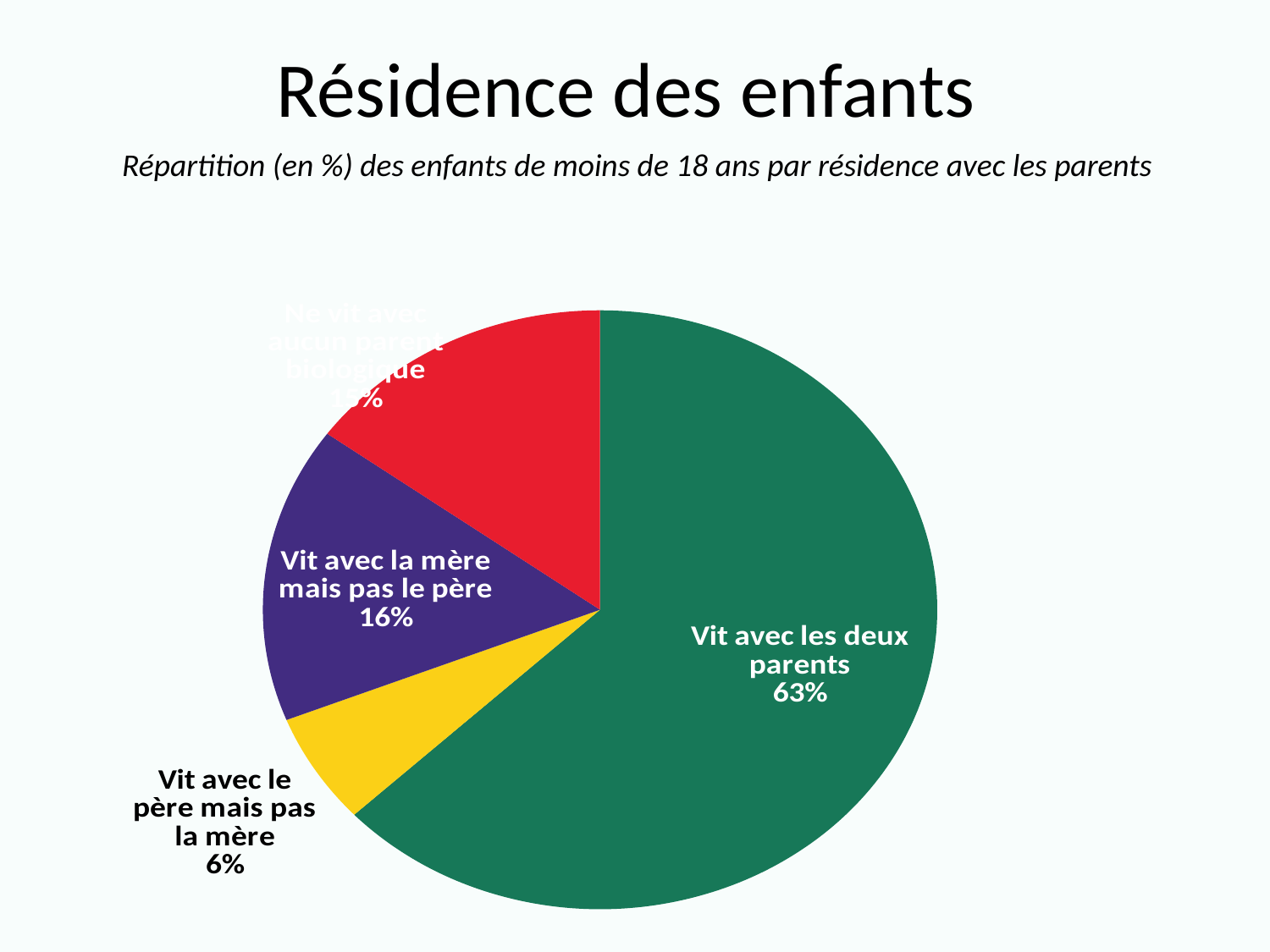
What is the difference between the share for 'Vit avec les deux parents' and the share for 'Vit avec la mère mais pas le père'? 47% How many slices does the pie chart have? 4 What percentage of children live with both parents (Vit avec les deux parents)? 63% What is the difference between the share for 'Vit avec la mère mais pas le père' and the share for 'Vit avec le père mais pas la mère'? 10% What percentage of children live with the mother but not the father (Vit avec la mère mais pas le père)? 16% What kind of chart is shown on the slide? Pie chart Which category has the largest share of the pie? Vit avec les deux parents Which is larger: the share for 'Vit avec la mère mais pas le père' or the share for 'Vit avec le père mais pas la mère'? Vit avec la mère mais pas le père Which category has the smallest share of the pie? Vit avec le père mais pas la mère What percentage of children live with the father but not the mother (Vit avec le père mais pas la mère)? 6% What colour is the slice for 'Vit avec les deux parents'? Green What is the title of the slide? Résidence des enfants